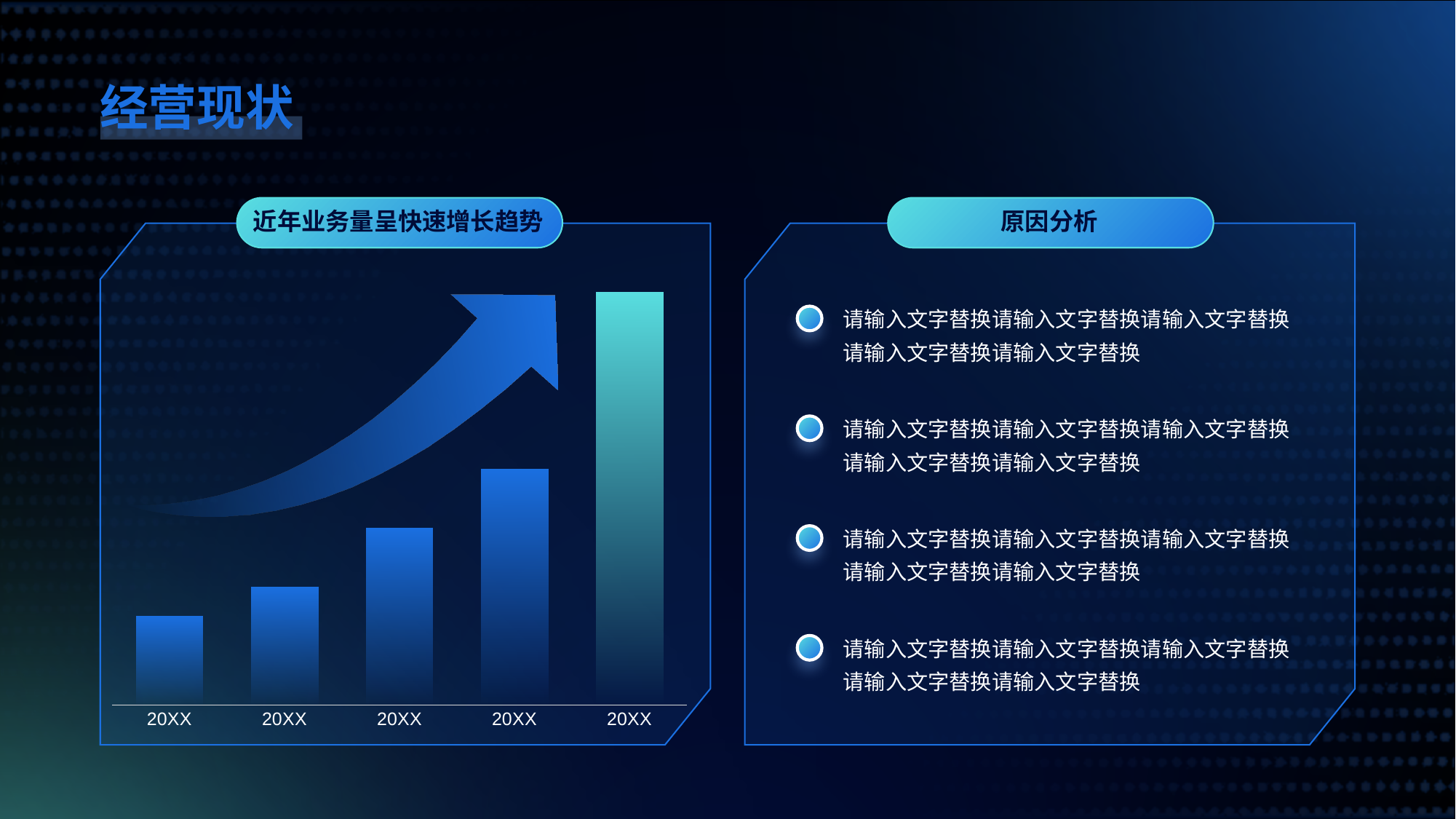
Do the bar values rise or fall from left to right along the x axis? Rise Is the third bar from the left taller or shorter than the second bar from the left? Taller Which bar is the tallest in the chart: the leftmost or the rightmost? The rightmost Is the second bar from the left taller or shorter than the fourth bar from the left? Shorter What kind of chart is shown on the left side of the slide? Bar chart What label appears under each bar on the x axis of the chart? 20XX Which bar is the shortest in the chart: the leftmost or the rightmost? The leftmost How many bars does the chart on the left contain? 5 What is the title shown above the bar chart? 近年业务量呈快速增长趋势